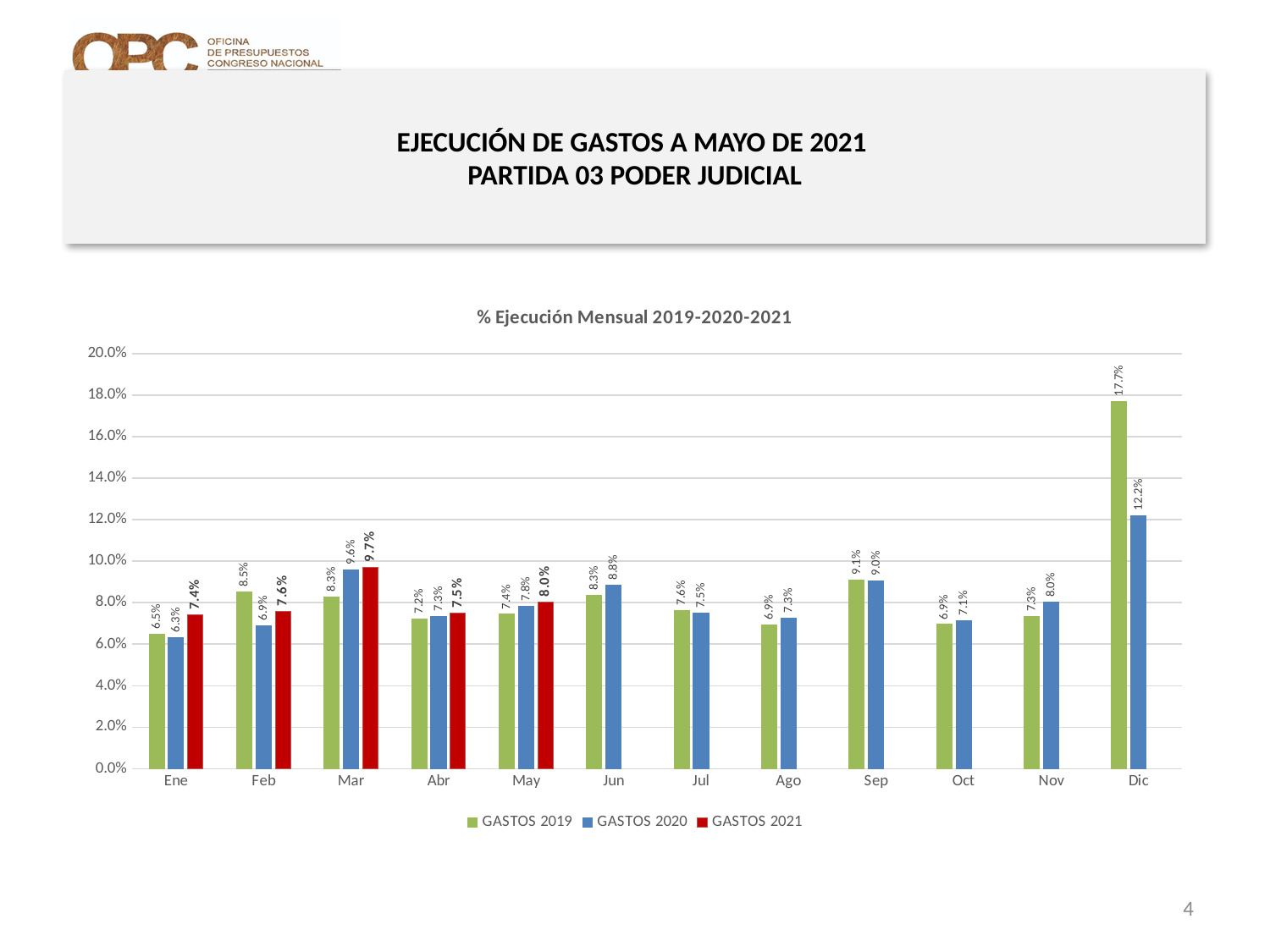
What kind of chart is shown on the slide? Bar chart Which month has the highest value for GASTOS 2020? Dic Which month has the lowest value for GASTOS 2020? Ene Is the value for GASTOS 2019 in Dic greater or less than 16.0%? greater What is the value for GASTOS 2019 in Dic? 17.7% How many series does the legend list? 3 How many months are shown on the x axis? 12 What is the title of the chart? % Ejecución Mensual 2019-2020-2021 What is the value for GASTOS 2020 in Nov? 8.0% What is the value for GASTOS 2021 in Mar? 9.7% What is the difference between GASTOS 2019 and GASTOS 2020 in Dic? 5.5% Which is larger in Feb: GASTOS 2019 or GASTOS 2020? GASTOS 2019